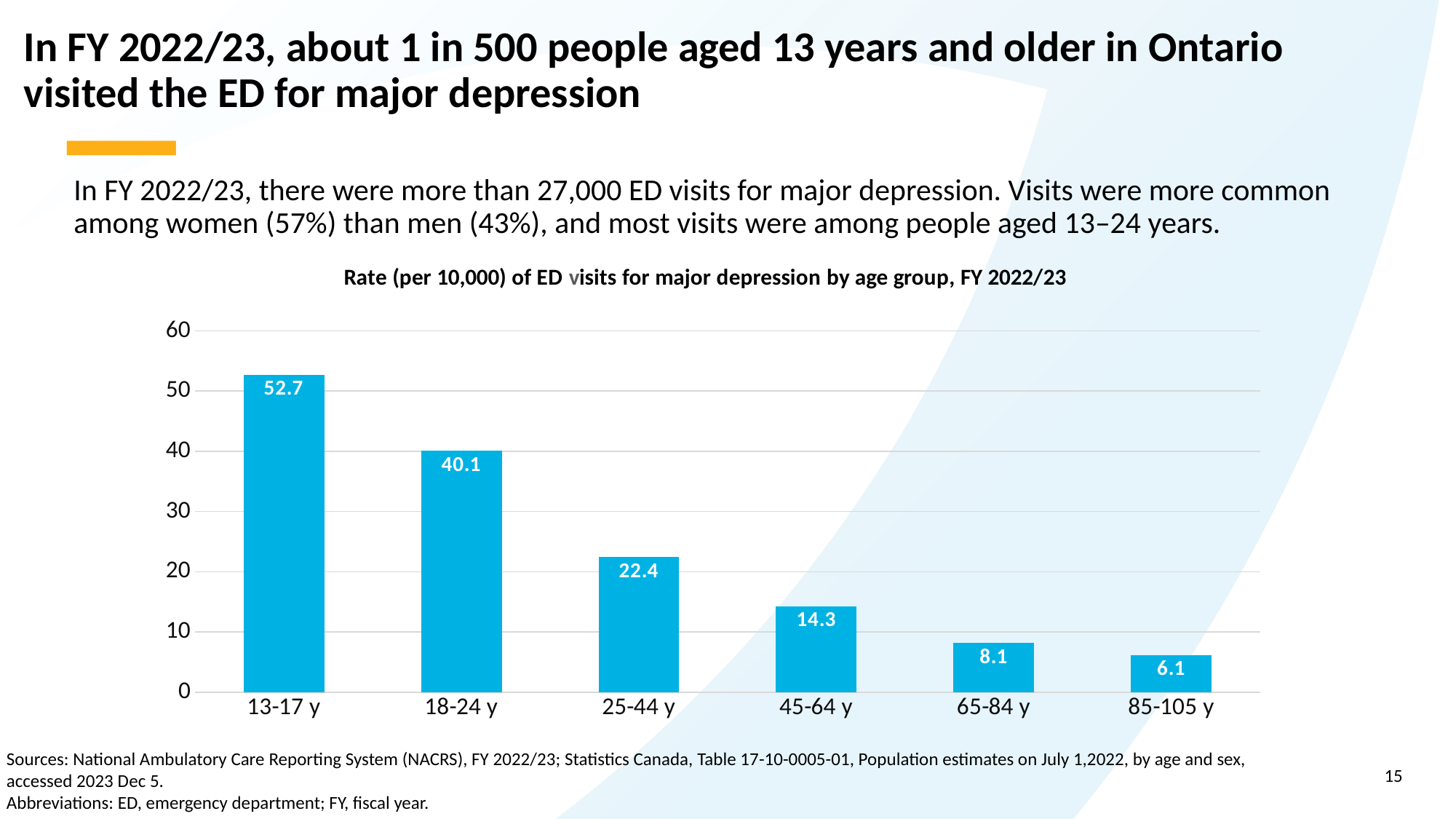
Do the rates rise or fall as age group increases along the x axis? Fall Is the rate for the 18-24 y age group greater or less than 40? greater Which age group has the highest rate of ED visits for major depression? 13-17 y Which age group has a higher rate of ED visits: 65-84 y or 85-105 y? 65-84 y How many age groups are shown in the chart? 6 What is the difference between the rates for the 25-44 y and 45-64 y age groups? 8.1 Which age group has the lowest rate of ED visits for major depression? 85-105 y What is the rate (per 10,000) of ED visits for major depression for the 45-64 y age group? 14.3 What is the rate (per 10,000) of ED visits for major depression for the 13-17 y age group? 52.7 What is the difference between the rates for the 13-17 y and 18-24 y age groups? 12.6 What is the rate (per 10,000) of ED visits for major depression for the 85-105 y age group? 6.1 What kind of chart is used to show the rate of ED visits by age group? Bar chart